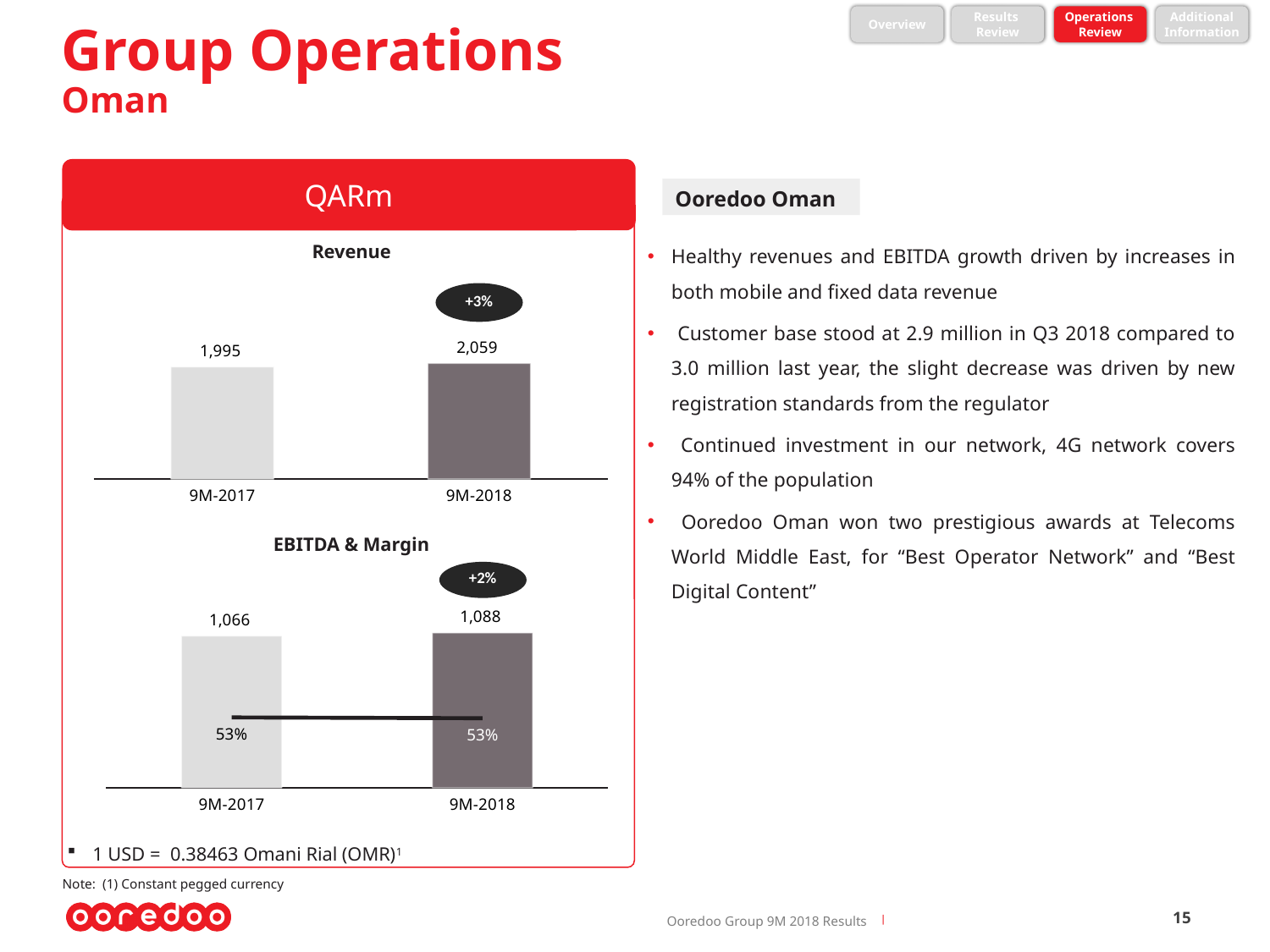
In the Revenue chart, what is the difference between the 9M-2018 and 9M-2017 values? 64 How many periods are shown in the EBITDA & Margin chart? 2 In the EBITDA & Margin chart, what is the difference between the 9M-2018 and 9M-2017 EBITDA values? 22 In the Revenue chart, what is the value for 9M-2018? 2,059 In the EBITDA & Margin chart, what is the EBITDA value for 9M-2017? 1,066 In the Revenue chart, what growth percentage is shown in the oval label? +3% In the Revenue chart, what is the value for 9M-2017? 1,995 What type of chart is the Revenue chart? Bar chart In the Revenue chart, which period has the higher revenue? 9M-2018 In the EBITDA & Margin chart, which period has the lower EBITDA? 9M-2017 In the EBITDA & Margin chart, what is the EBITDA value for 9M-2018? 1,088 In the EBITDA & Margin chart, what is the margin for 9M-2018? 53%